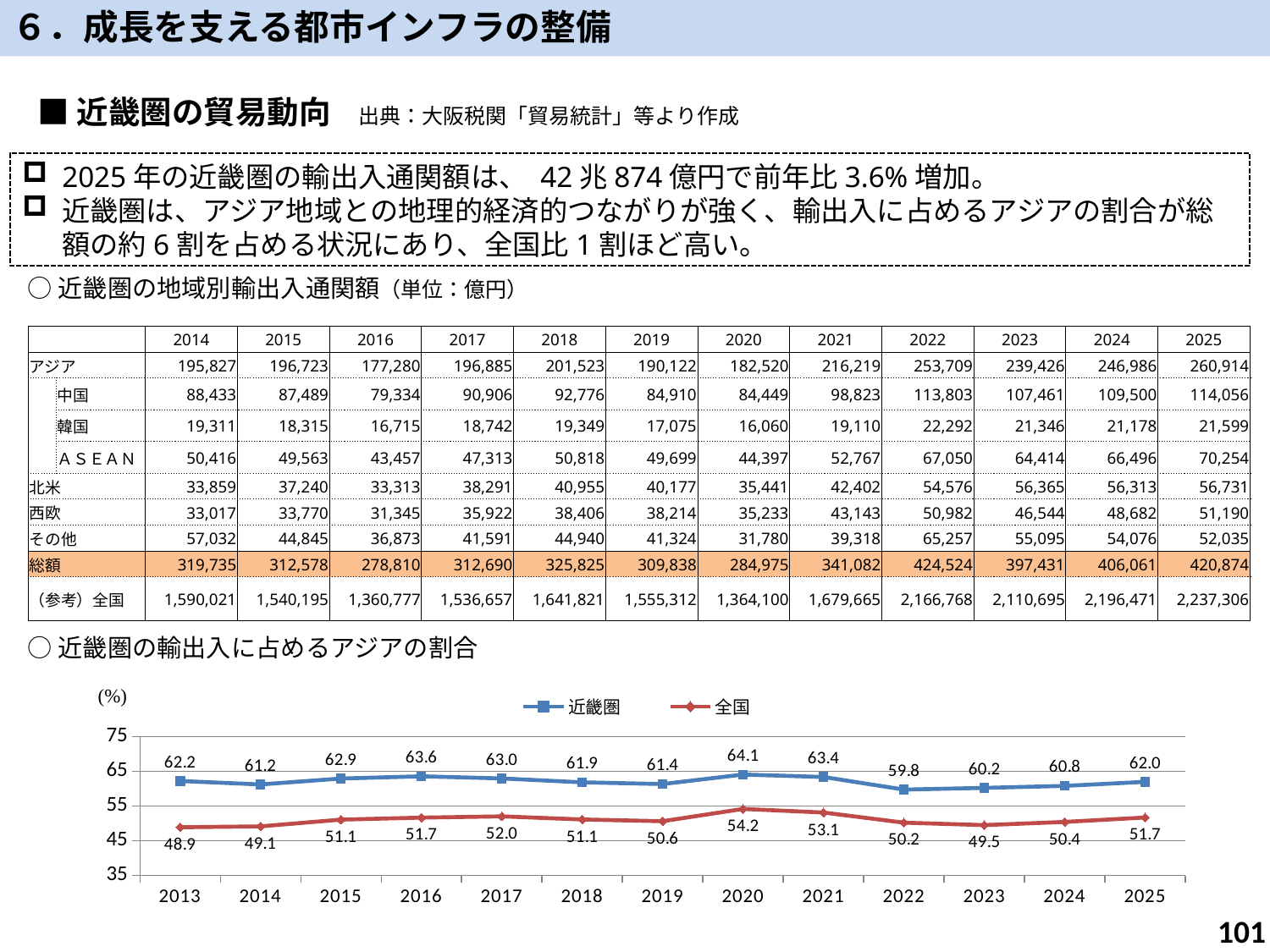
In the line chart of the share of Asia in Kinki region trade, what is the value for 近畿圏 in 2020? 64.1 In the line chart, what is the value for 全国 in 2013? 48.9 How many series does the legend of the line chart list? 2 In the line chart, in which year is the 全国 series highest? 2020 In the line chart, what is the value for 近畿圏 in 2025? 62.0 In the line chart, in which year is the 近畿圏 series lowest? 2022 In the line chart, does the 近畿圏 series rise or fall from 2021 to 2022? fall What kind of chart is shown at the bottom of the slide? line chart How many years are plotted on the x axis of the line chart? 13 In the line chart, is the value for 全国 in 2020 greater or less than 55? less In the line chart, what is the difference between the 近畿圏 and 全国 values in 2025? 10.3 In the line chart, which series has the larger value in 2016, 近畿圏 or 全国? 近畿圏